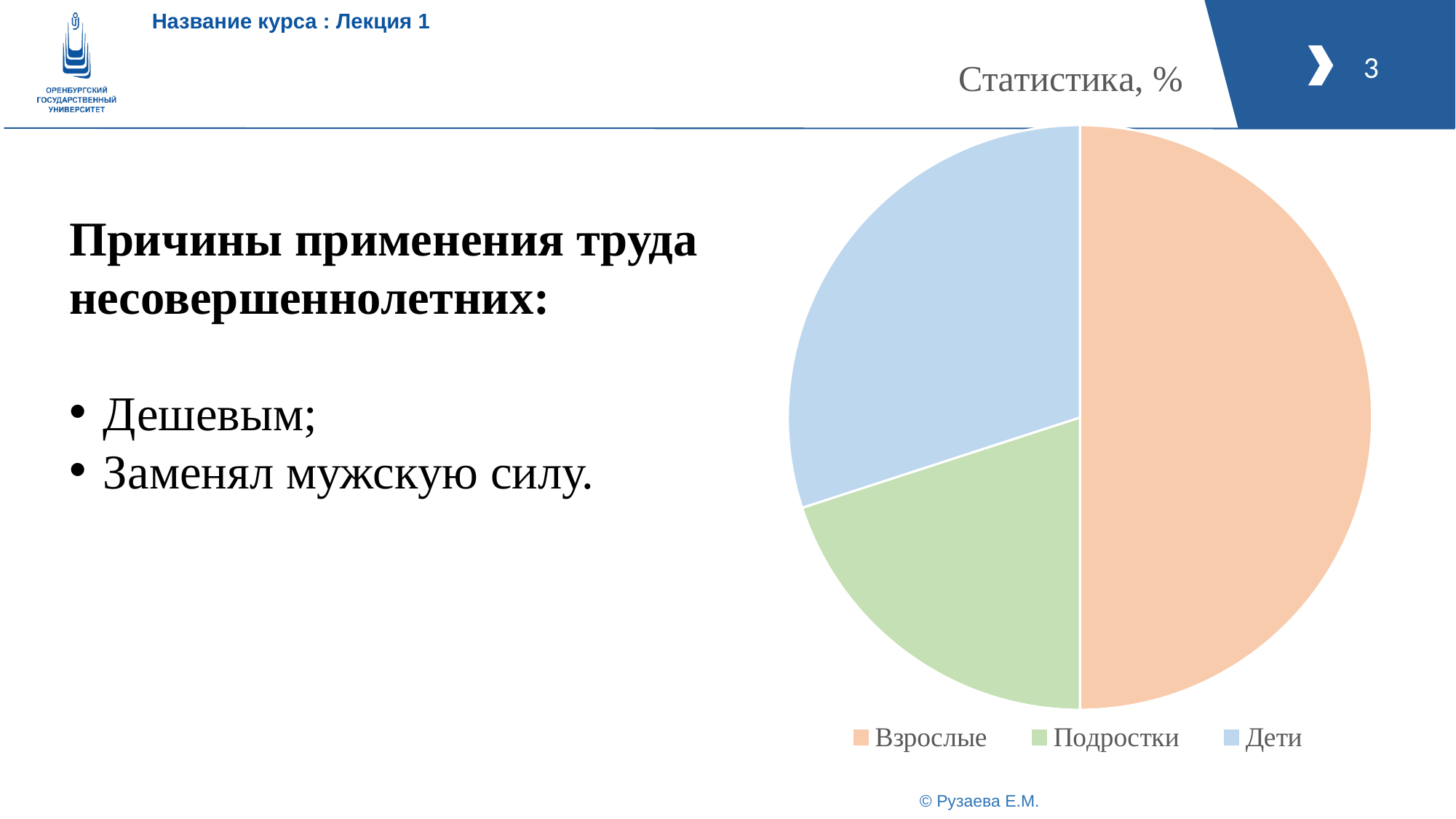
What kind of chart is shown on the slide? pie chart Which slice is larger in the pie chart, Дети or Подростки? Дети Which category has the largest slice in the pie chart? Взрослые Which category has the smallest slice in the pie chart? Подростки What is the title of the pie chart? Статистика, % What colour is the Подростки slice in the pie chart? green How many slices does the pie chart have? 3 Which slice is larger in the pie chart, Взрослые or Дети? Взрослые How many entries does the legend of the pie chart list? 3